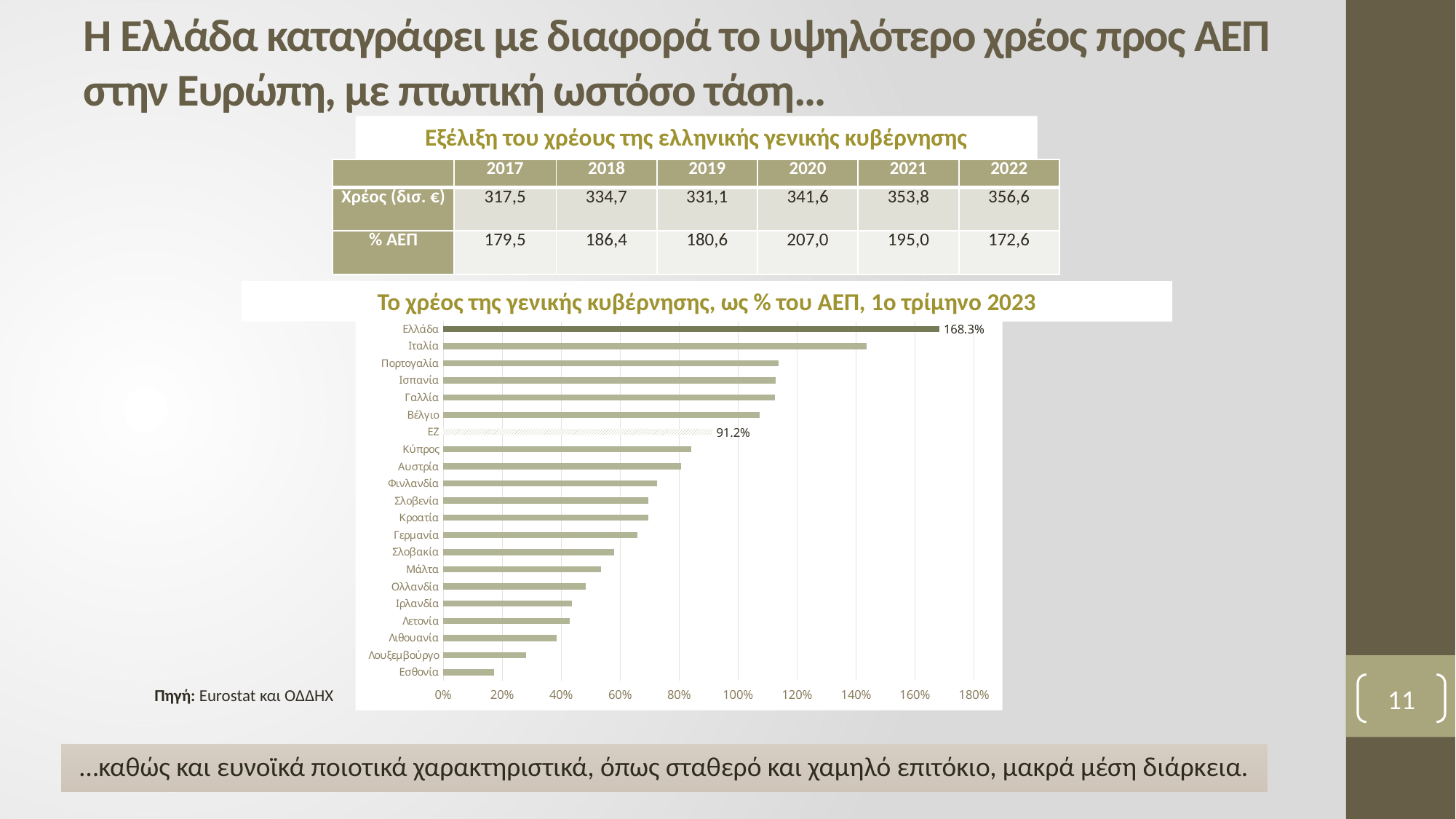
What is the value shown for ΕΖ in the bar chart? 91.2% Which category has the highest value in the bar chart? Ελλάδα What is the value shown for Ελλάδα in the chart 'Το χρέος της γενικής κυβέρνησης, ως % του ΑΕΠ, 1ο τρίμηνο 2023'? 168.3% How many bars (categories) are shown in the bar chart? 21 In the bar chart, which has the larger value: Ιταλία or Πορτογαλία? Ιταλία Which category has the lowest value in the bar chart? Εσθονία What type of chart is used to show government debt as % of GDP for the 1st quarter of 2023? Bar chart Is the value for Ιταλία in the bar chart greater or less than 120%? greater In the bar chart, which has the larger value: Βέλγιο or Κύπρος? Βέλγιο By how many percentage points does the value for Ελλάδα exceed the value for ΕΖ in the bar chart? 77.1 percentage points Is the value for Κύπρος in the bar chart greater or less than 100%? less Is the value for Εσθονία in the bar chart greater or less than 20%? less